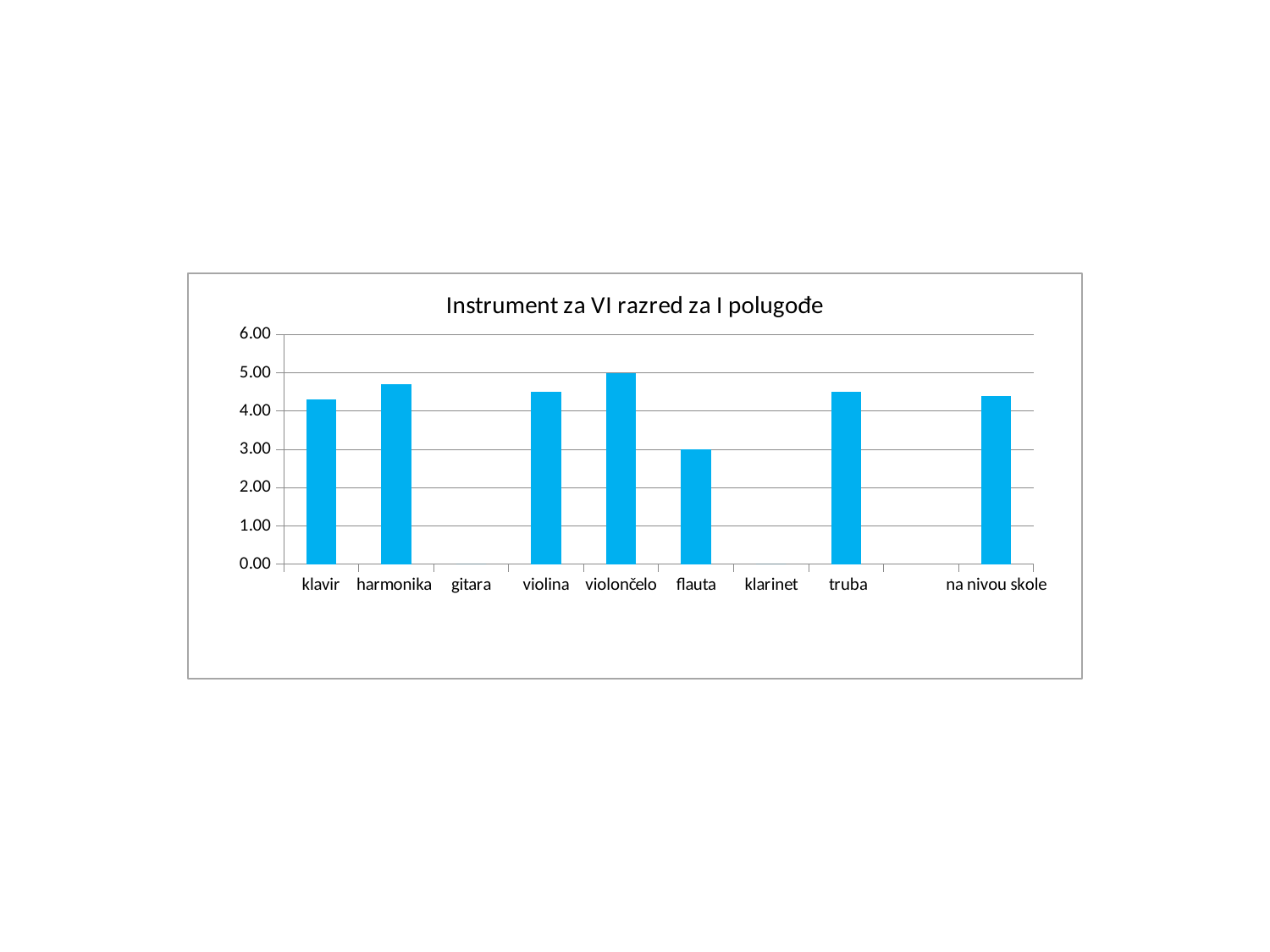
What is the value for flauta? 3.00 What is the value for violončelo? 5.00 What is the difference between the values for violončelo and flauta? 2.00 Which is larger, the value for harmonika or the value for klavir? harmonika Among the categories with a visible bar, which has the lowest value? flauta Is the value for harmonika greater or less than 5.00? less Which category has the highest value? violončelo How many bars are visible in the chart? 7 Is the value for klavir greater or less than 4.00? greater Is the value for na nivou skole greater or less than 4.00? greater What is the title of the chart? Instrument za VI razred za I polugođe What kind of chart is shown on the slide? bar chart